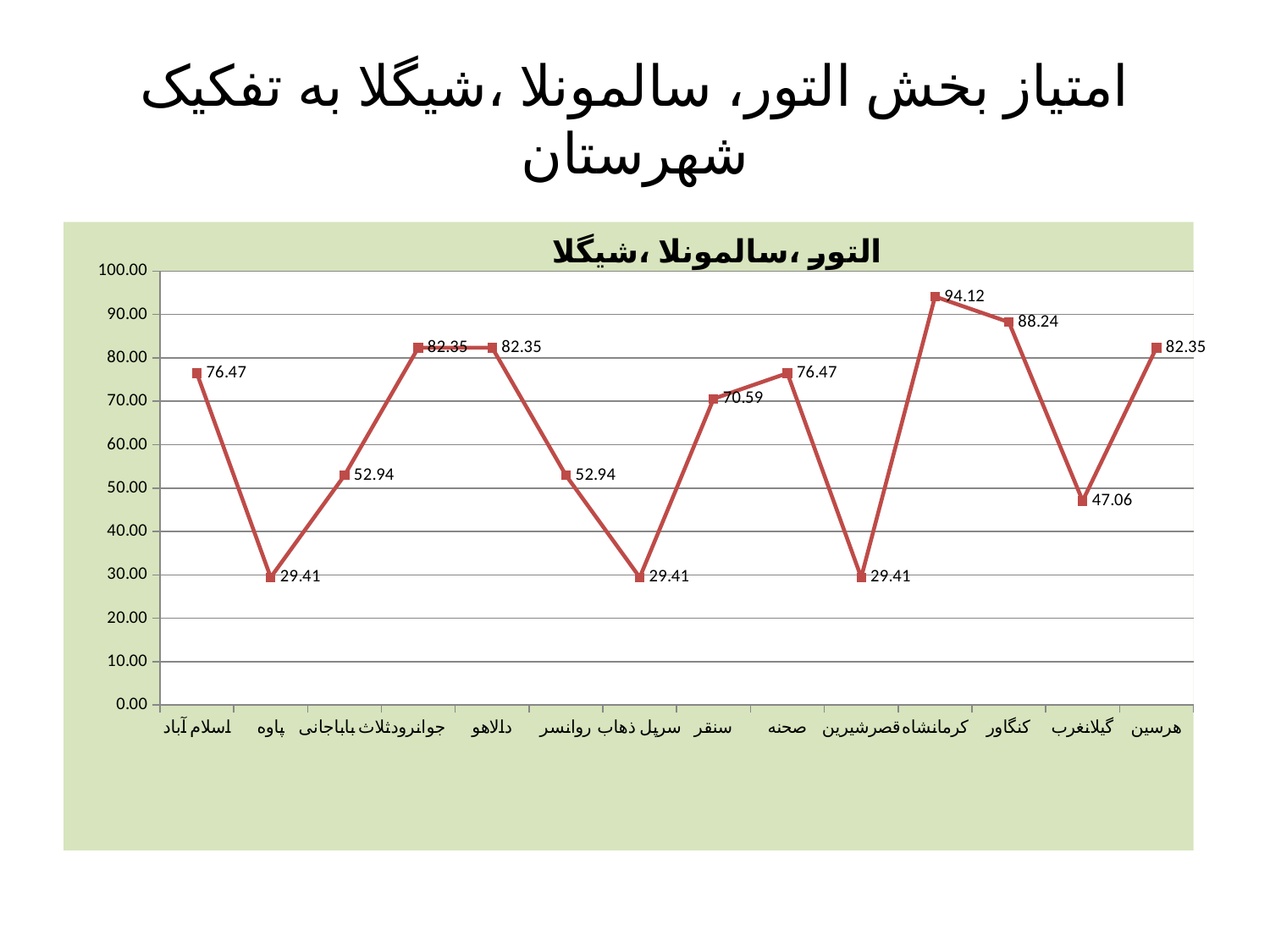
What is the value for پاوه? 29.41 What is the value for کرمانشاه? 94.12 What is the value for سنقر? 70.59 What is the title of the chart? التور ،سالمونلا ،شیگلا What is the difference between the values for هرسین and گیلانغرب? 35.29 What type of chart is shown on the slide? line chart Is the value for اسلام آباد greater or less than 70.00? greater Which category has the highest value? کرمانشاه What is the value for گیلانغرب? 47.06 What is the difference between the values for کرمانشاه and کنگاور? 5.88 How many categories are plotted on the x axis? 14 Which is larger, the value for صحنه or the value for سنقر? صحنه